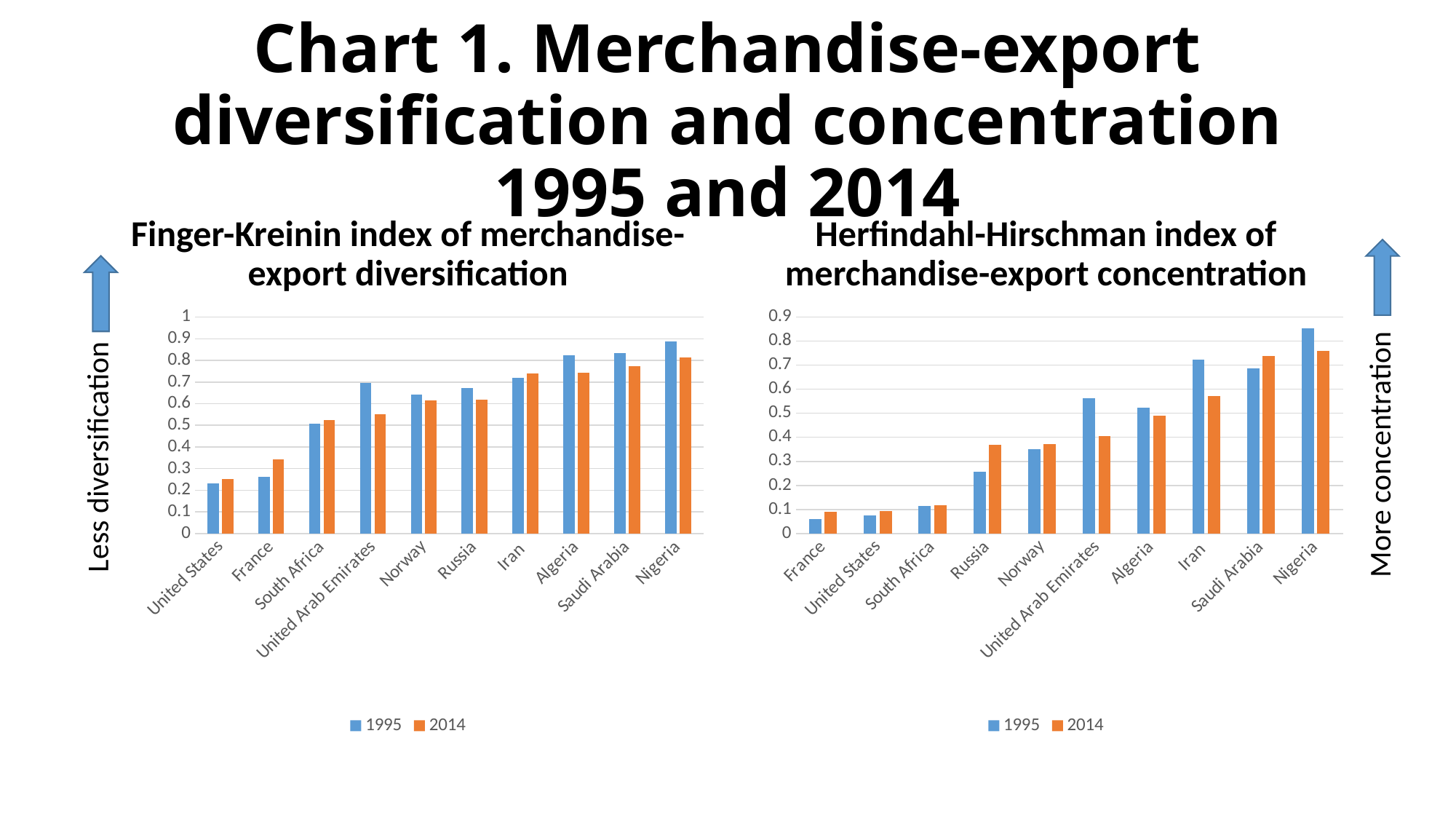
In the Herfindahl-Hirschman index chart, is the 2014 value for Saudi Arabia greater or less than 0.8? less In the Finger-Kreinin index chart, is the 1995 value for Nigeria greater or less than 0.8? greater How many countries are shown on the Finger-Kreinin index of merchandise-export diversification chart? 10 How many series does the legend of the Herfindahl-Hirschman index chart list? 2 In the Herfindahl-Hirschman index chart, which country has the highest 2014 value? Nigeria In the Herfindahl-Hirschman index chart, which is larger for Iran: the 1995 value or the 2014 value? 1995 In the Herfindahl-Hirschman index chart, is the 1995 value for Iran greater or less than 0.6? greater In the Finger-Kreinin index chart, which country has the highest 1995 value? Nigeria What kind of chart is the Finger-Kreinin index of merchandise-export diversification chart? bar chart In the Finger-Kreinin index chart, which is larger for France: the 1995 value or the 2014 value? 2014 In the Finger-Kreinin index chart, which country has the lowest 1995 value? United States In the Herfindahl-Hirschman index chart, which country has the lowest 1995 value? France